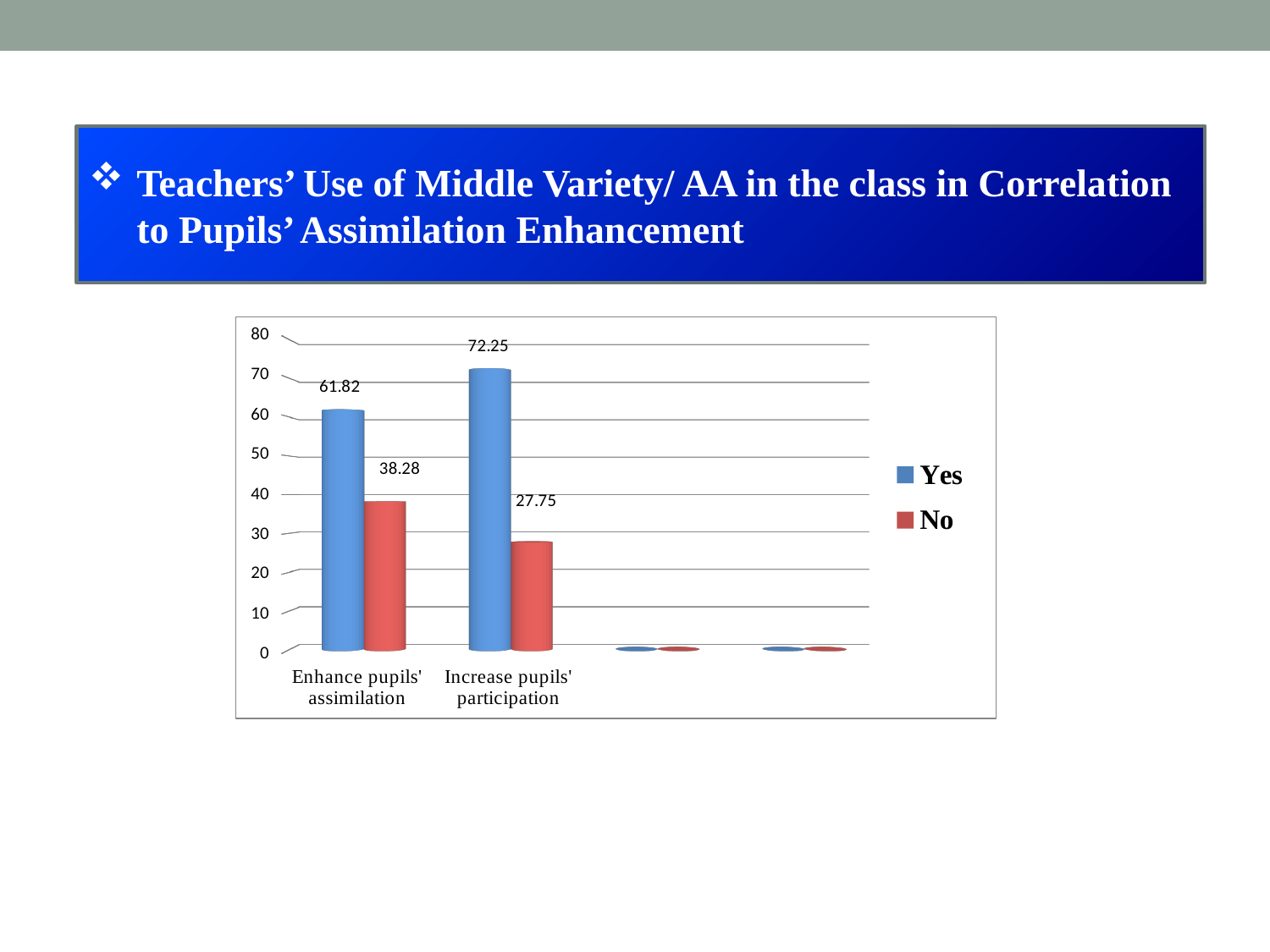
What is the difference between the Yes and No values for Enhance pupils' assimilation? 23.54 What is the value for No for Increase pupils' participation? 27.75 What is the value for Yes for Enhance pupils' assimilation? 61.82 Which category has the highest Yes value? Increase pupils' participation Which category has the lowest No value? Increase pupils' participation What is the difference between the Yes values for Increase pupils' participation and Enhance pupils' assimilation? 10.43 Which is larger for Increase pupils' participation, the Yes value or the No value? Yes What is the value for Yes for Increase pupils' participation? 72.25 Is the No value for Enhance pupils' assimilation greater or less than 40? less How many series does the legend list? 2 What is the value for No for Enhance pupils' assimilation? 38.28 What kind of chart is shown on the slide? bar chart